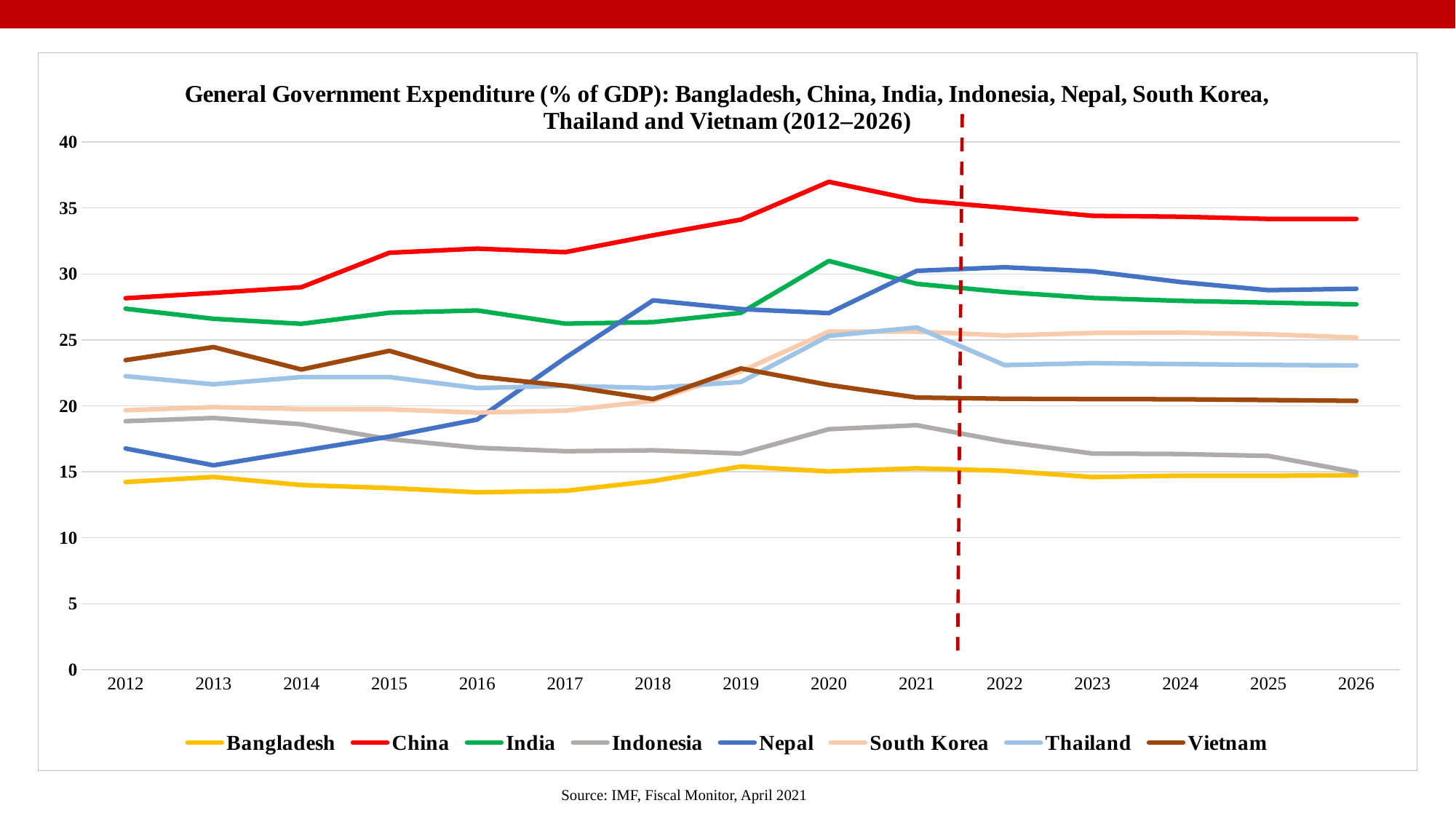
How many years are shown along the x axis? 15 In 2018, which is larger: the value for Nepal or the value for India? Nepal Is India's value in 2020 greater or less than 30? greater What kind of chart is shown on the slide? Line chart Does Nepal's line rise or fall between 2013 and 2021? Rises Is China's value in 2020 greater or less than 35? greater Which country has the highest general government expenditure (% of GDP) in 2020? China How many countries (series) does the legend list? 8 What colour is the line for China? Red Is Bangladesh's value in 2016 greater or less than 15? less Which country has the lowest general government expenditure (% of GDP) in 2020? Bangladesh In 2015, which is larger: the value for Vietnam or the value for Thailand? Vietnam